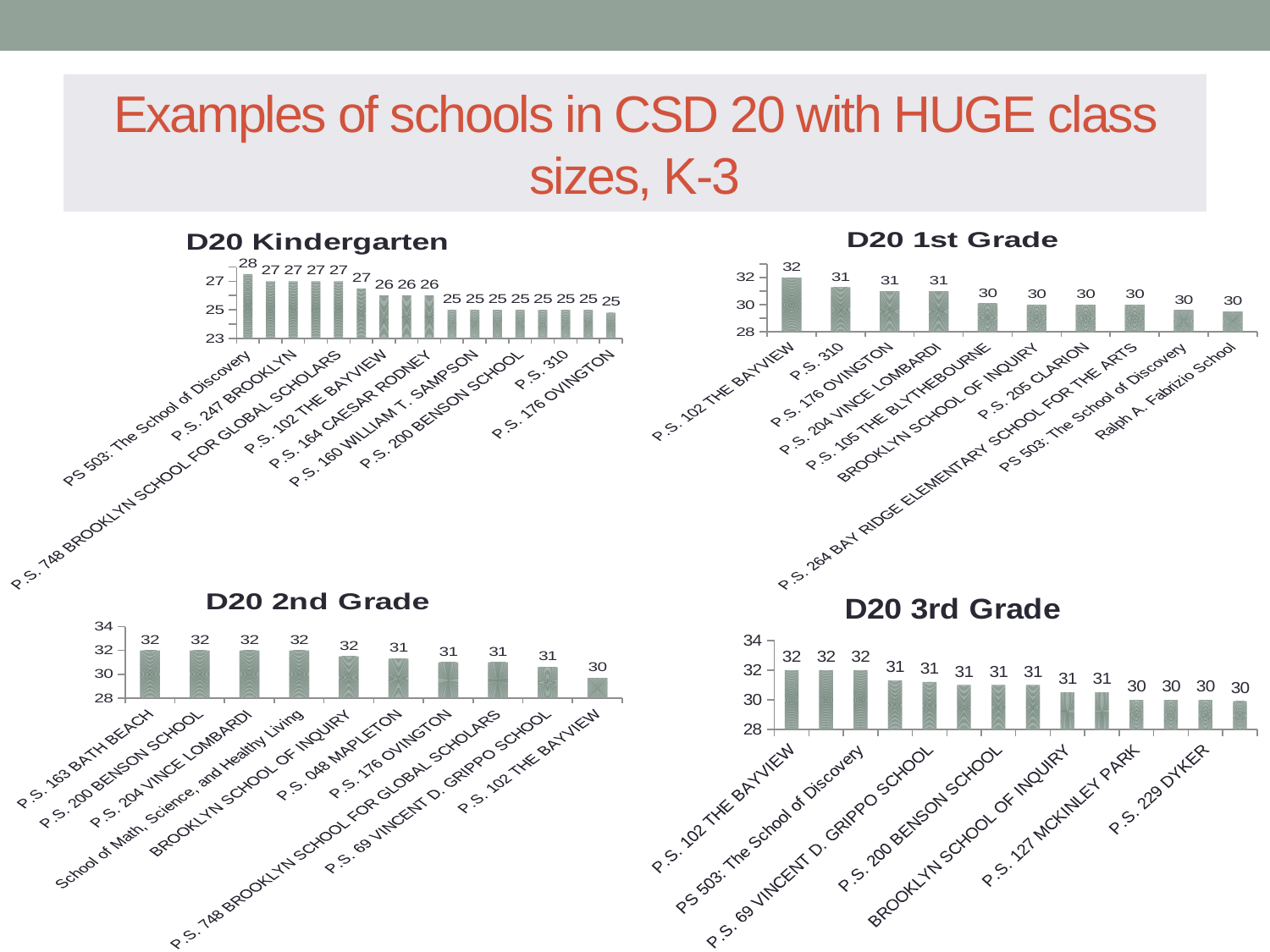
In the D20 1st Grade chart, which school has the highest value? P.S. 102 THE BAYVIEW How many schools are shown in the D20 1st Grade chart? 10 In the D20 1st Grade chart, what is the value for Ralph A. Fabrizio School? 30 In the D20 3rd Grade chart, what is the value for P.S. 102 THE BAYVIEW? 32 In the D20 2nd Grade chart, which school has the lowest value? P.S. 102 THE BAYVIEW In the D20 Kindergarten chart, what is the value for PS 503: The School of Discovery? 28 In the D20 2nd Grade chart, what is the value for P.S. 102 THE BAYVIEW? 30 In the D20 2nd Grade chart, which is larger, the value for P.S. 163 BATH BEACH or the value for P.S. 048 MAPLETON? P.S. 163 BATH BEACH How many schools are shown in the D20 2nd Grade chart? 10 In the D20 2nd Grade chart, do the values rise or fall from left to right? fall In the D20 1st Grade chart, what is the value for P.S. 102 THE BAYVIEW? 32 In the D20 1st Grade chart, what is the difference between the values for P.S. 102 THE BAYVIEW and P.S. 310? 1